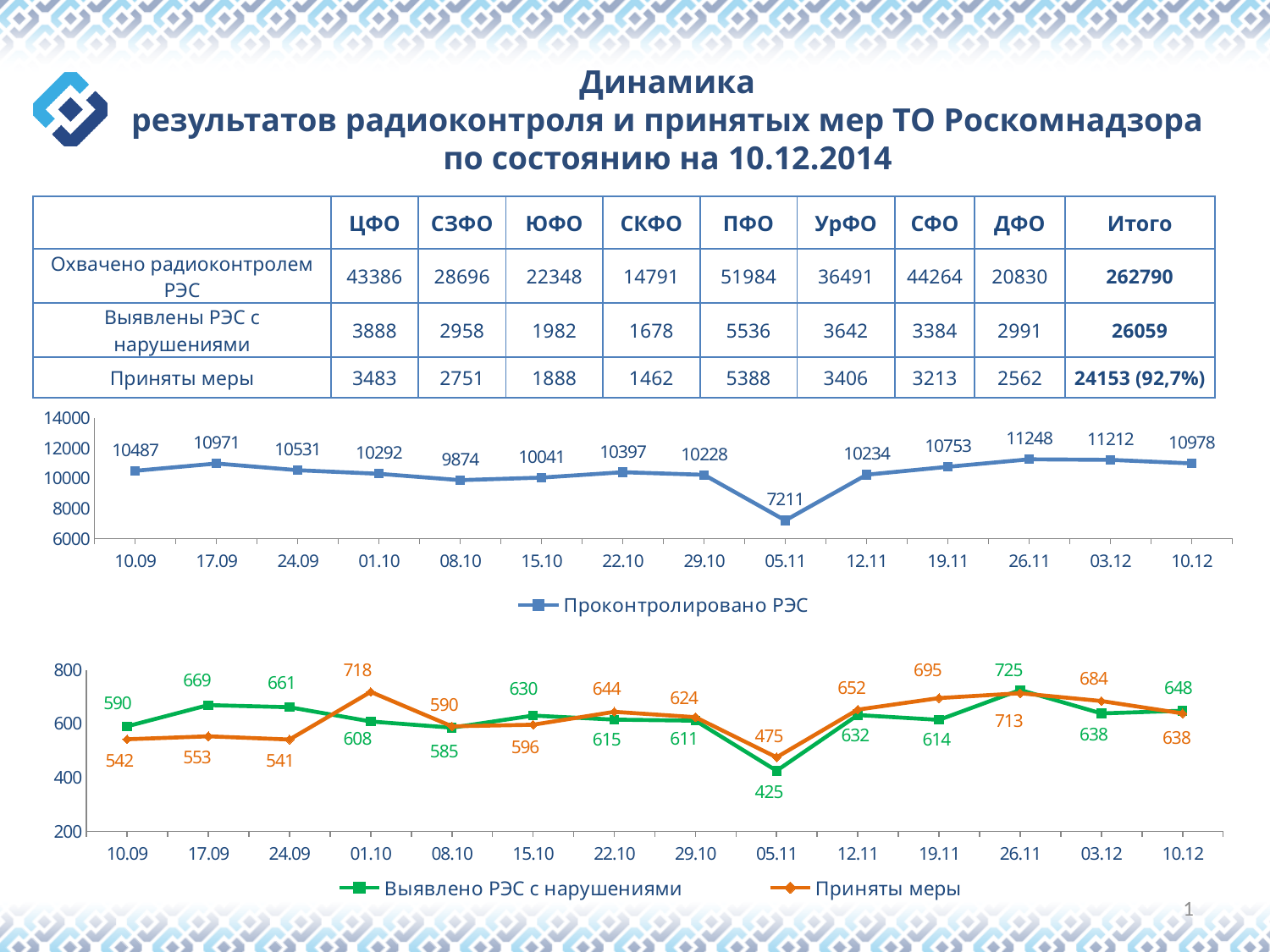
In the top chart (Проконтролировано РЭС), what is the value for 05.11? 7211 In the top chart (Проконтролировано РЭС), what is the difference between the values for 26.11 and 05.11? 4037 How many series does the legend of the bottom chart list? 2 In the top chart (Проконтролировано РЭС), which date has the lowest value? 05.11 In the top chart (Проконтролировано РЭС), which date has the highest value? 26.11 In the top chart (Проконтролировано РЭС), how many data points are plotted? 14 In the bottom chart, which date has the highest value for Выявлено РЭС с нарушениями? 26.11 In the bottom chart, what is the value of Выявлено РЭС с нарушениями for 05.11? 425 In the bottom chart, what is the value of Приняты меры for 01.10? 718 In the bottom chart, what is the difference between Выявлено РЭС с нарушениями and Приняты меры for 10.09? 48 What type of chart is the top chart (Проконтролировано РЭС)? line chart In the bottom chart, which is larger for 01.10: Выявлено РЭС с нарушениями or Приняты меры? Приняты меры